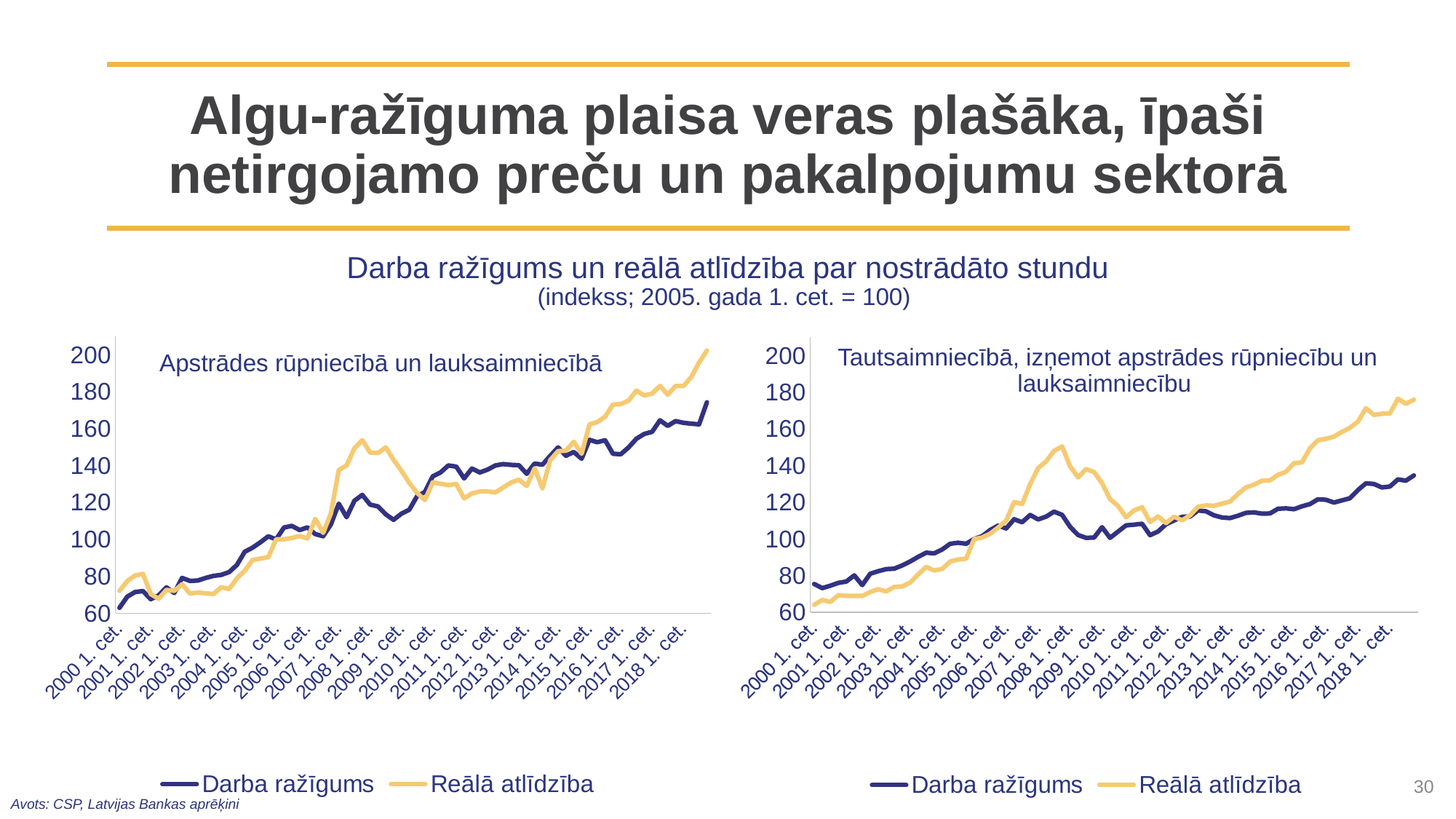
How many series does the legend of the right chart ('Tautsaimniecībā, izņemot apstrādes rūpniecību un lauksaimniecību') list? 2 In the left chart ('Apstrādes rūpniecībā un lauksaimniecībā'), is the value of Reālā atlīdzība at 2000 1. cet. greater or less than 80? less In the left chart ('Apstrādes rūpniecībā un lauksaimniecībā'), is the value of Darba ražīgums at the end of the series (2018) greater or less than 160? greater In the right chart ('Tautsaimniecībā, izņemot apstrādes rūpniecību un lauksaimniecību'), does Darba ražīgums overall rise or fall from 2000 to 2018? rise In the right chart ('Tautsaimniecībā, izņemot apstrādes rūpniecību un lauksaimniecību'), is the value of Reālā atlīdzība at the end of the series (2018) greater or less than 160? greater What kind of chart is the left chart titled 'Apstrādes rūpniecībā un lauksaimniecībā'? line chart In the left chart ('Apstrādes rūpniecībā un lauksaimniecībā'), which colour is the Reālā atlīdzība line? yellow In the right chart ('Tautsaimniecībā, izņemot apstrādes rūpniecību un lauksaimniecību'), at the end of the series (2018), which is higher: Darba ražīgums or Reālā atlīdzība? Reālā atlīdzība What is the title of the right chart? Tautsaimniecībā, izņemot apstrādes rūpniecību un lauksaimniecību In the left chart ('Apstrādes rūpniecībā un lauksaimniecībā'), at the end of the series (2018), which is higher: Darba ražīgums or Reālā atlīdzība? Reālā atlīdzība